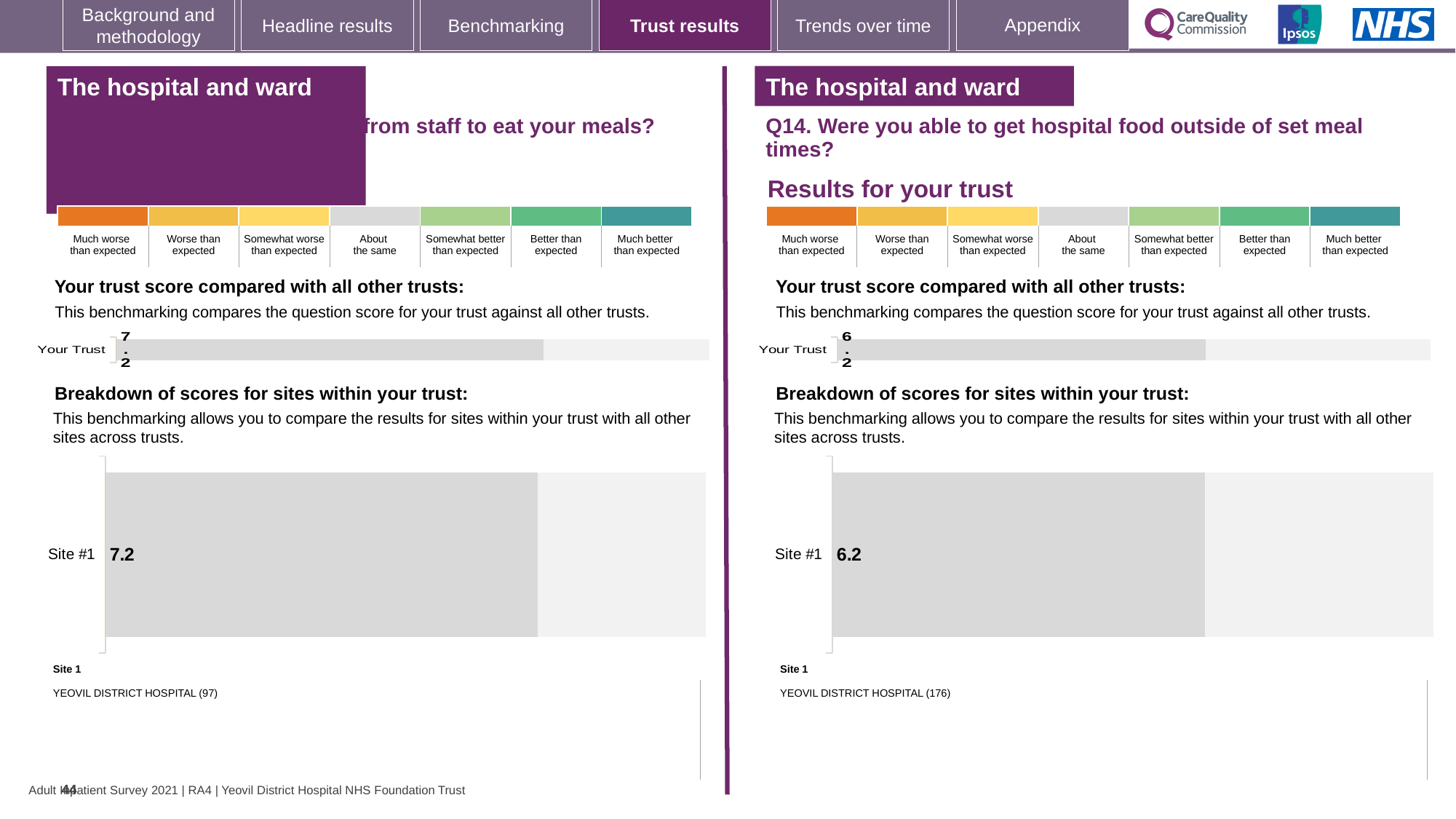
What type of chart is used to show the Site #1 score in the right-hand (Q14) breakdown section? Bar chart What is the difference between the Your Trust score on the left-hand side (7.2) and the Your Trust score on the right-hand side (6.2)? 1.0 On the right-hand side of the slide (Q14), what score is shown for Site #1 in the 'Breakdown of scores for sites within your trust' chart? 6.2 Is the Your Trust score on the right-hand side (Q14) greater or less than the Your Trust score on the left-hand side? less In the right-hand (Q14) breakdown chart, which site is listed as Site 1? YEOVIL DISTRICT HOSPITAL (176) Which is larger: the Site #1 score in the left-hand breakdown chart or the Site #1 score in the right-hand (Q14) breakdown chart? Left-hand chart (7.2) How many sites are shown in the 'Breakdown of scores for sites within your trust' chart on the right-hand side (Q14)? 1 On the left-hand side of the slide, what is the score shown for Your Trust in the 'Your trust score compared with all other trusts' chart? 7.2 How many sites are shown in the 'Breakdown of scores for sites within your trust' chart on the left-hand side? 1 On the left-hand side of the slide, what score is shown for Site #1 in the 'Breakdown of scores for sites within your trust' chart? 7.2 On the right-hand side of the slide (Q14), what is the score shown for Your Trust in the 'Your trust score compared with all other trusts' chart? 6.2 In the left-hand breakdown chart, which site is listed as Site 1? YEOVIL DISTRICT HOSPITAL (97)